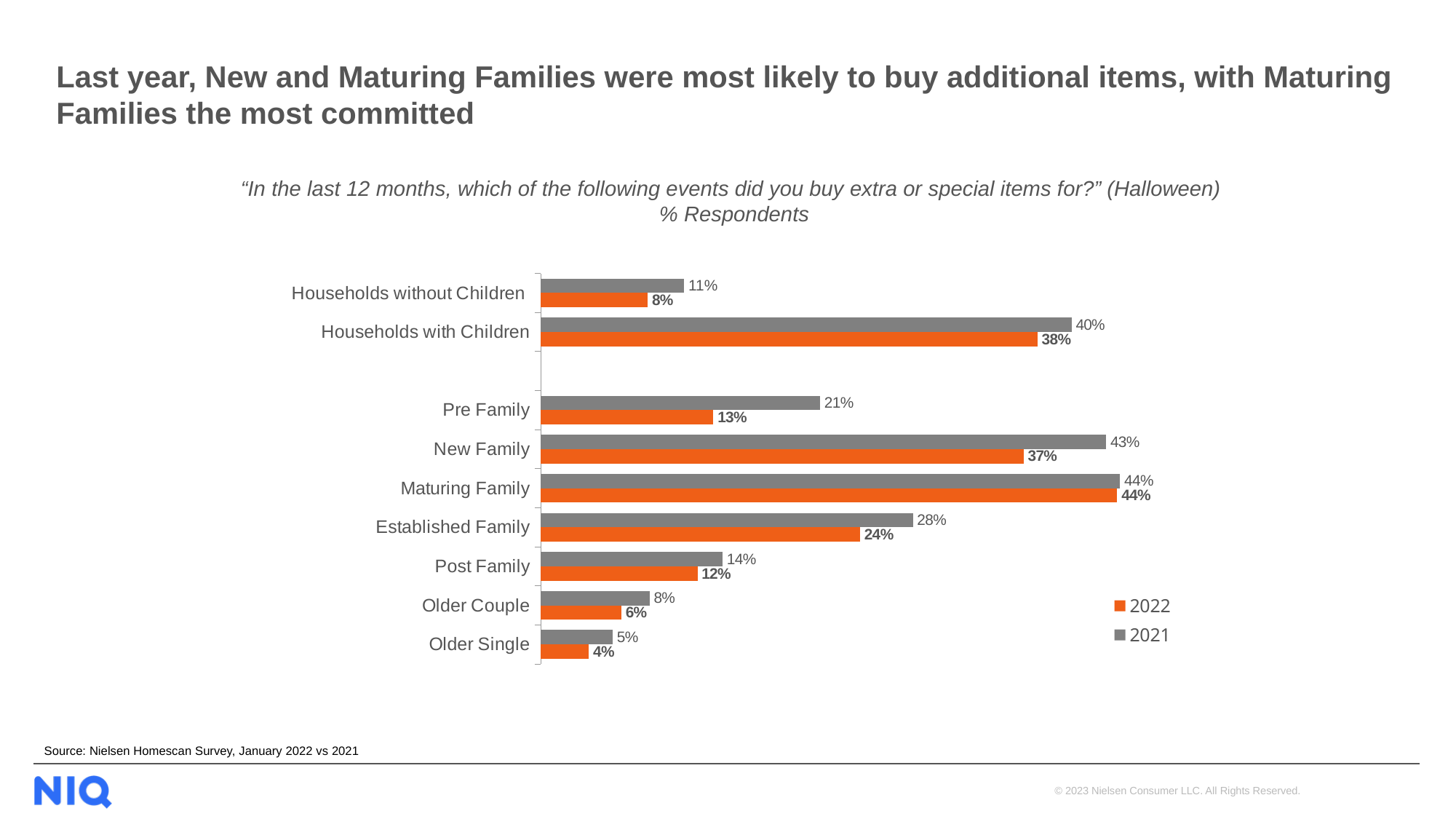
What is the difference between the 2022 values for New Family and Post Family? 25% What is the 2021 value for Pre Family? 21% What is the 2022 value for Households with Children? 38% How many series does the legend list? 2 What is the difference between the 2021 and 2022 values for Pre Family? 8% What is the 2022 value for Established Family? 24% What kind of chart is shown on the slide? Bar chart Which colour represents the 2022 series? Orange Which category has the lowest 2021 value? Older Single How many categories are shown on the chart? 9 Which is larger, the 2021 value for Households with Children or the 2021 value for New Family? New Family Which category has the highest 2022 value? Maturing Family